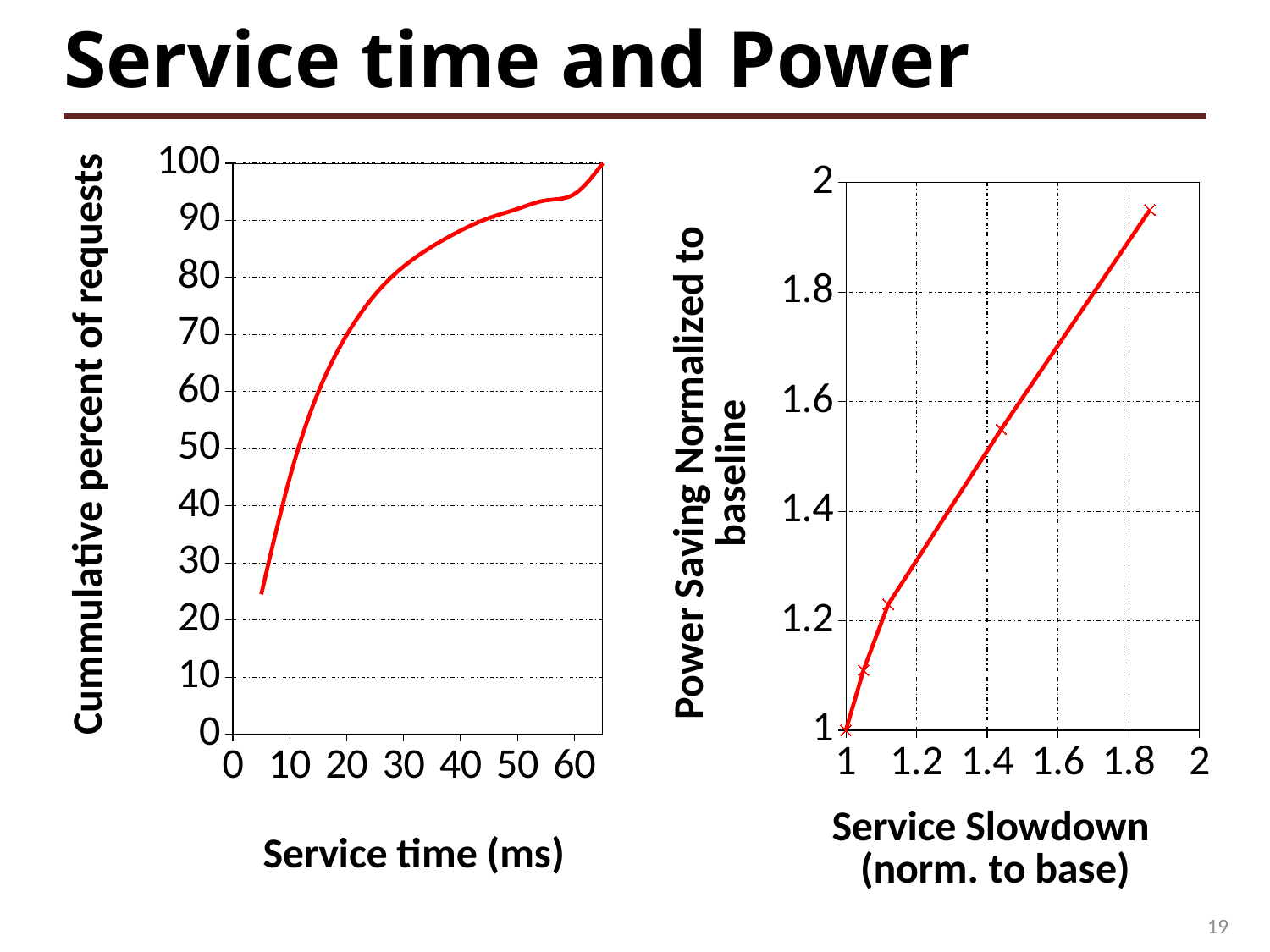
What is the label of the x axis of the right chart? Service Slowdown (norm. to base) In the right chart, does power saving rise or fall as service slowdown increases? rise In the left chart, is the cumulative percent of requests at a service time of 60 ms greater or less than 90? greater What is the label of the x axis of the left chart? Service time (ms) In the left chart, is the cumulative percent of requests at a service time of 40 ms greater or less than 90? less In the right chart, what is the power saving value at a service slowdown of 1? 1 What kind of chart is the right chart (Power Saving Normalized to baseline vs Service Slowdown)? line chart In the left chart, is the cumulative percent of requests at a service time of 20 ms greater or less than 60? greater What kind of chart is the left chart (Cummulative percent of requests vs Service time)? line chart How many data points are marked on the line in the right chart? 5 In the left chart, does the cumulative percent of requests rise or fall as service time increases? rise